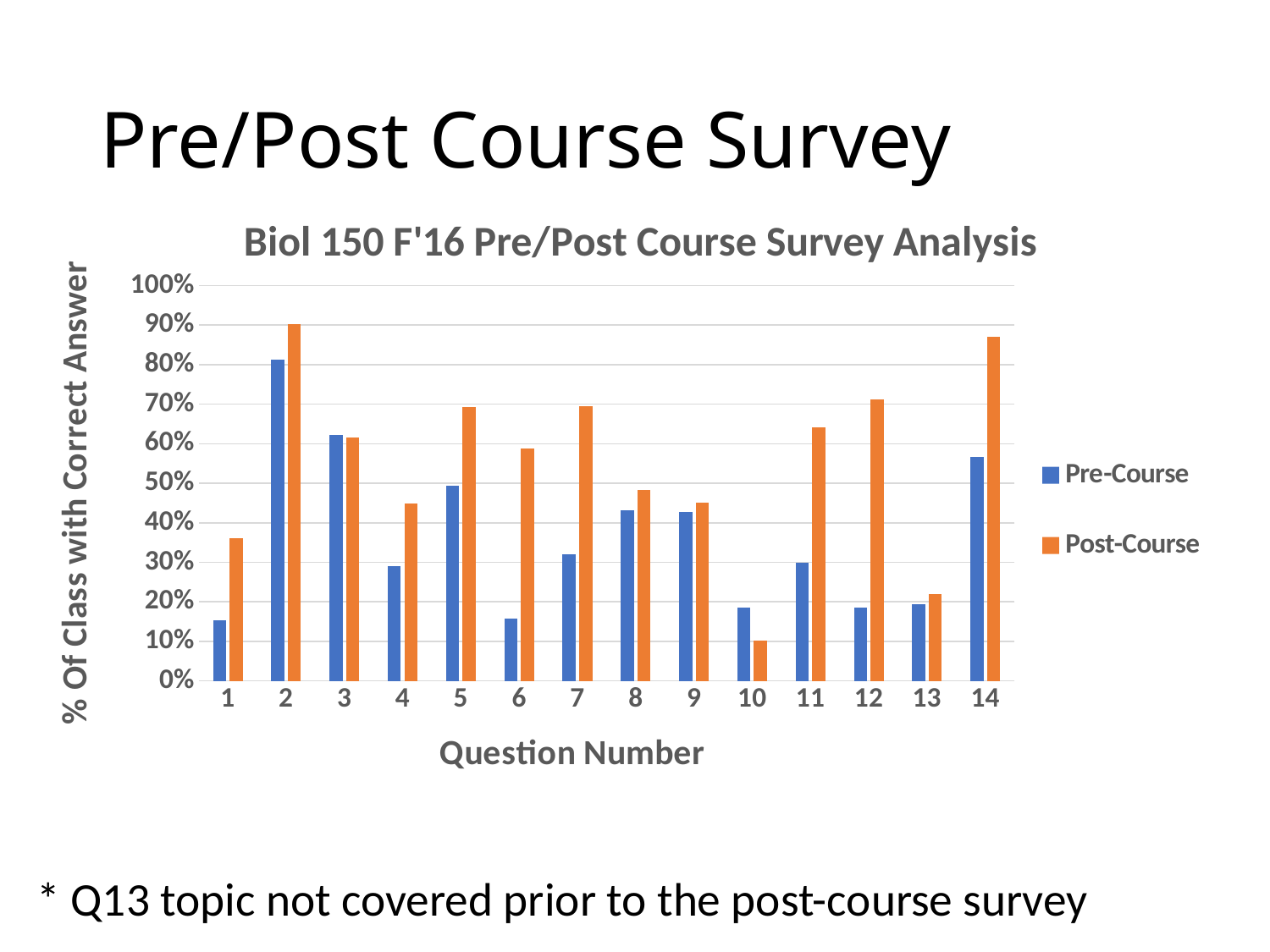
Which question has the lowest Post-Course value? 10 For question 10, which is larger: the Pre-Course or the Post-Course value? Pre-Course What is the title of the chart? Biol 150 F'16 Pre/Post Course Survey Analysis Which question has the highest Post-Course value? 2 Is the Post-Course value for question 10 greater or less than 20%? less What type of chart is shown on the slide? bar chart Which question has the highest Pre-Course value? 2 For question 12, which is larger: the Pre-Course or the Post-Course value? Post-Course How many question numbers are shown along the x axis? 14 Is the Post-Course value for question 14 greater or less than 80%? greater Is the Pre-Course value for question 6 greater or less than 20%? less How many series does the legend list? 2